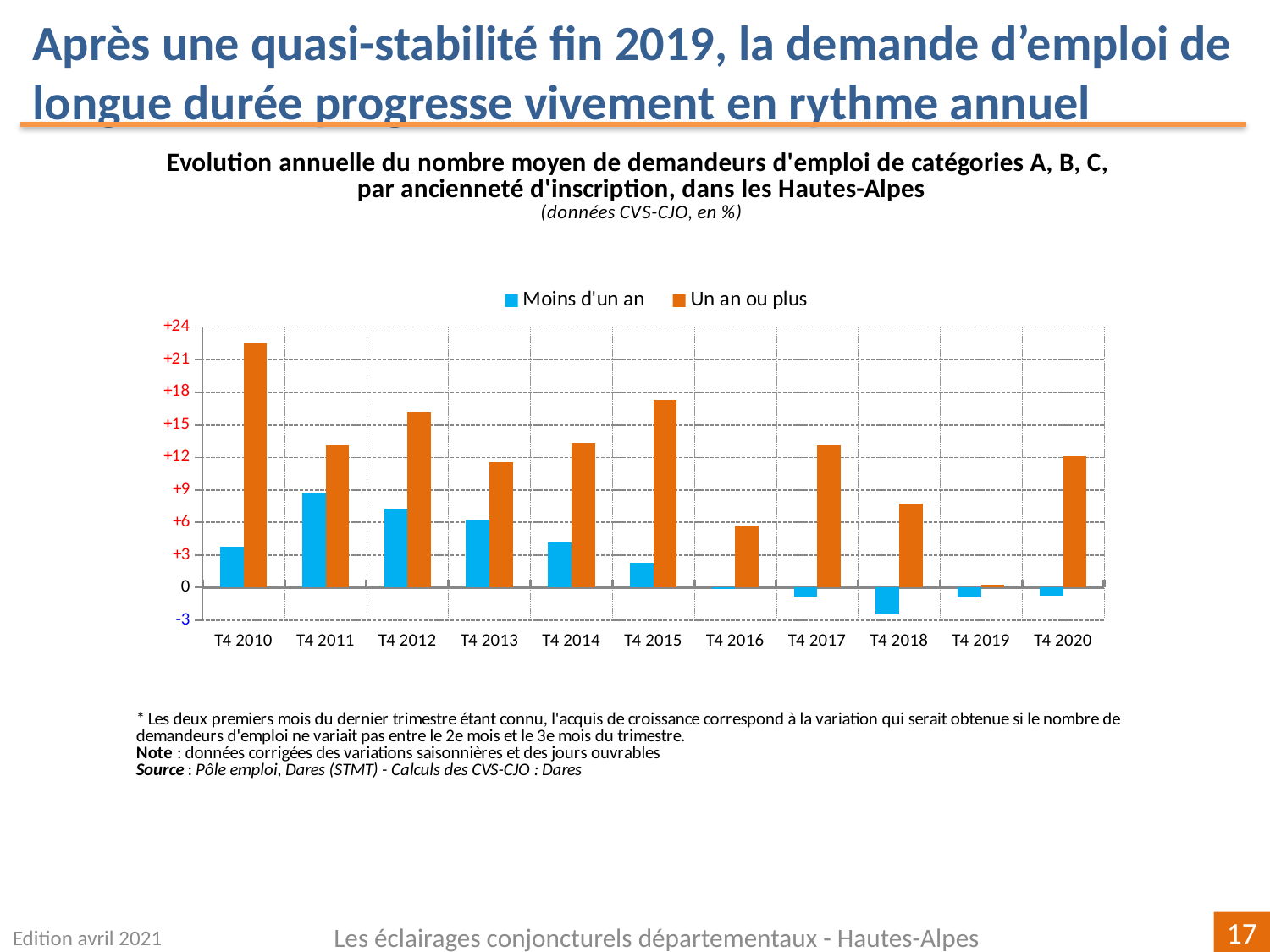
For the series 'Un an ou plus', which quarter has the highest value? T4 2010 What kind of chart is shown on the slide? bar chart Which colour represents the series 'Un an ou plus' in the legend? orange Is the value for 'Un an ou plus' in T4 2010 greater or less than +21? greater For the series 'Moins d'un an', which quarter has the highest value? T4 2011 Is the value for 'Moins d'un an' in T4 2012 greater or less than +6? greater In T4 2020, which series has the larger value, 'Moins d'un an' or 'Un an ou plus'? Un an ou plus How many quarters (categories) are shown on the x axis? 11 How many series does the legend list? 2 For the series 'Un an ou plus', which quarter has the lowest value? T4 2019 For the series 'Moins d'un an', which quarter has the lowest value? T4 2018